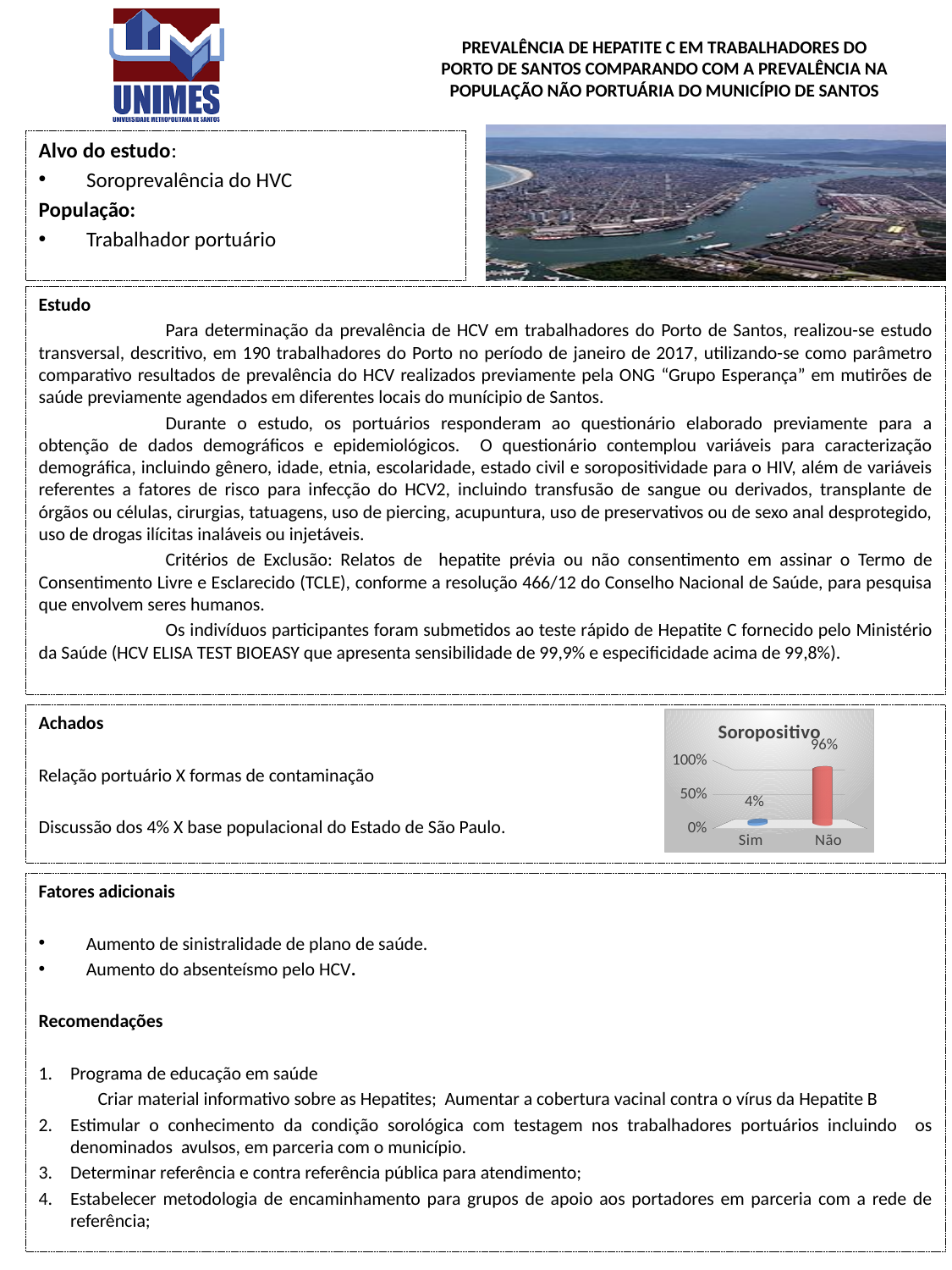
Which category has the highest value in the Soropositivo chart? Não Which category has the lowest value in the Soropositivo chart? Sim Is the value for "Não" in the Soropositivo chart greater or less than 50%? greater In the Soropositivo chart, which is larger, the value for "Sim" or the value for "Não"? Não Is the value for "Sim" in the Soropositivo chart greater or less than 50%? less How many categories are shown in the Soropositivo chart? 2 What kind of chart is the Soropositivo chart? bar chart What is the highest value shown on the vertical axis of the Soropositivo chart? 100% What is the value for "Não" in the Soropositivo chart? 96% What is the difference between the values for "Não" and "Sim" in the Soropositivo chart? 92% What is the value for "Sim" in the Soropositivo chart? 4% What is the title of the chart on the slide? Soropositivo